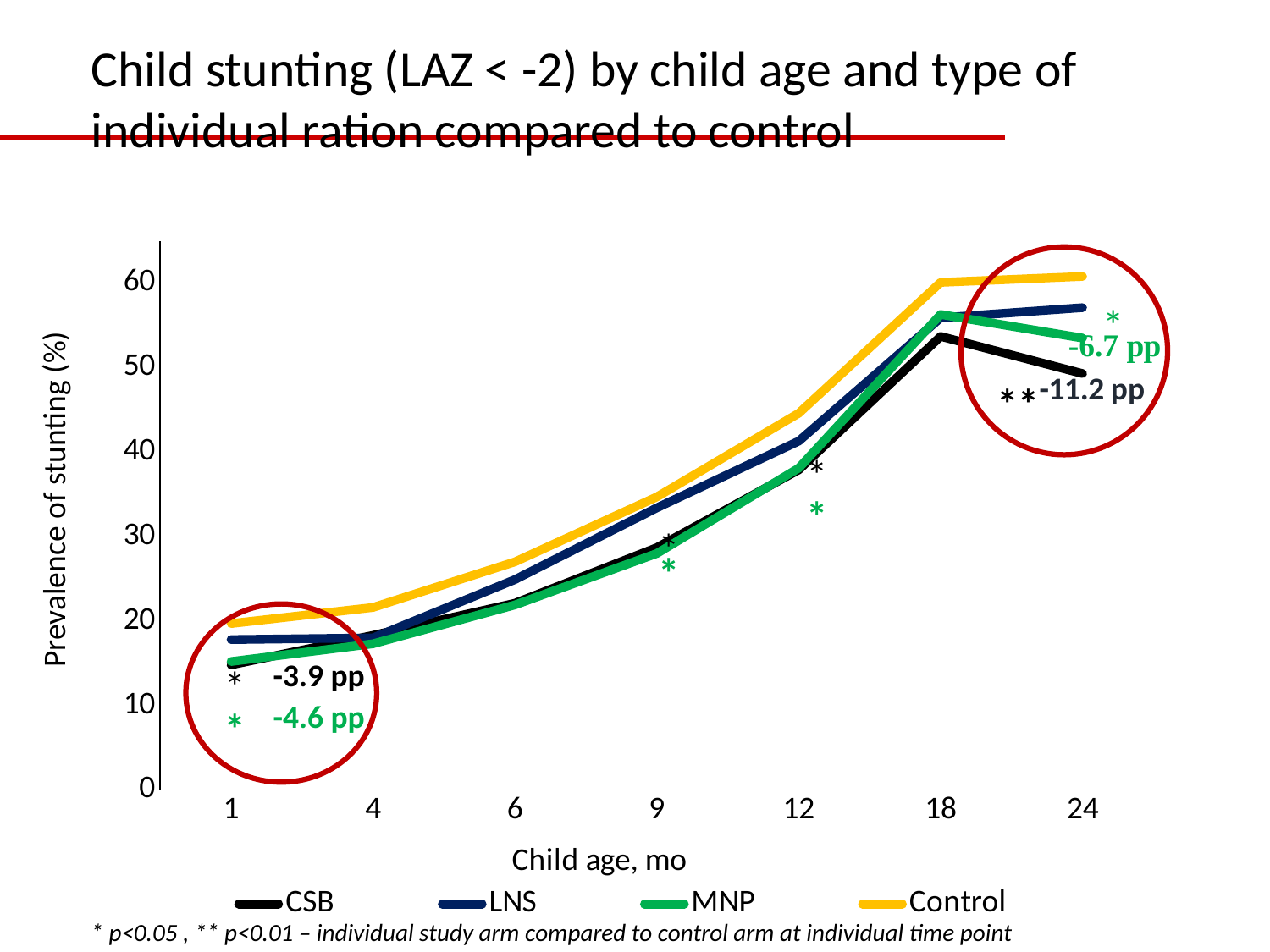
What percentage-point difference is annotated for MNP compared to control at 1 month? -4.6 pp Is the prevalence of stunting for Control at 12 months greater or less than 40? greater Does the prevalence of stunting for Control rise or fall from 1 month to 18 months? rise What kind of chart is shown on the slide? line chart What percentage-point difference is annotated for CSB compared to control at 24 months? -11.2 pp How many child age points are shown on the x axis? 7 Is the prevalence of stunting for LNS at 1 month greater or less than 20? less Is the prevalence of stunting for MNP at 12 months greater or less than 40? less Which series has the lowest prevalence of stunting at 24 months? CSB Which series has the highest prevalence of stunting at 24 months? Control How many series does the legend list? 4